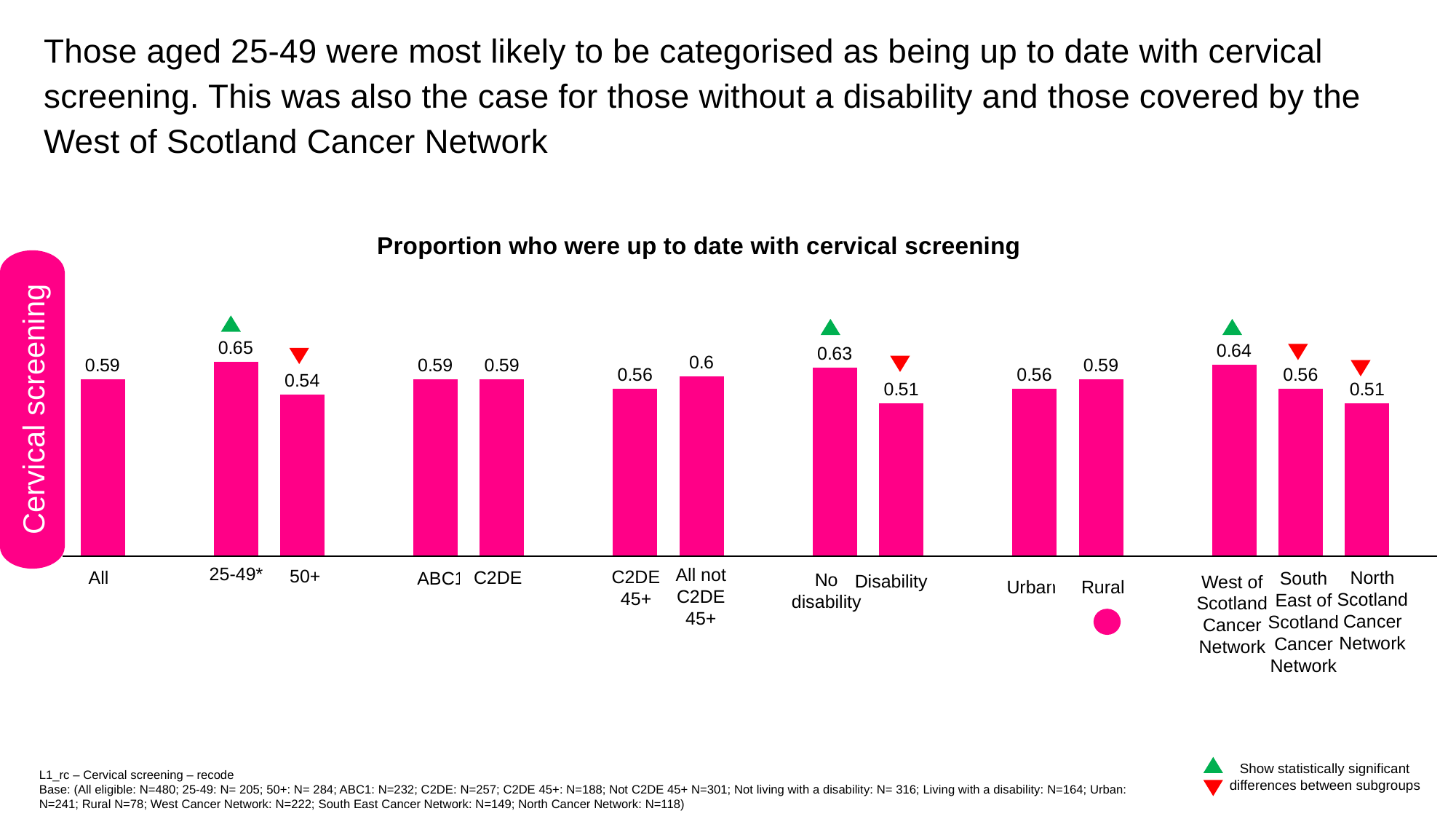
Which category has the highest value? 25-49* How many bars are plotted in the chart? 14 What is the value for the 25-49* category? 0.65 What is the value for the West of Scotland Cancer Network? 0.64 What is the value for the 'All' category? 0.59 What kind of chart is shown on the slide? Bar chart What is the title of the chart? Proportion who were up to date with cervical screening What is the difference between the values for No disability and Disability? 0.12 What is the value for the 'All not C2DE 45+' category? 0.6 What is the difference between the values for 25-49* and 50+? 0.11 Which has a larger value, Urban or Rural? Rural What is the value for the Disability category? 0.51